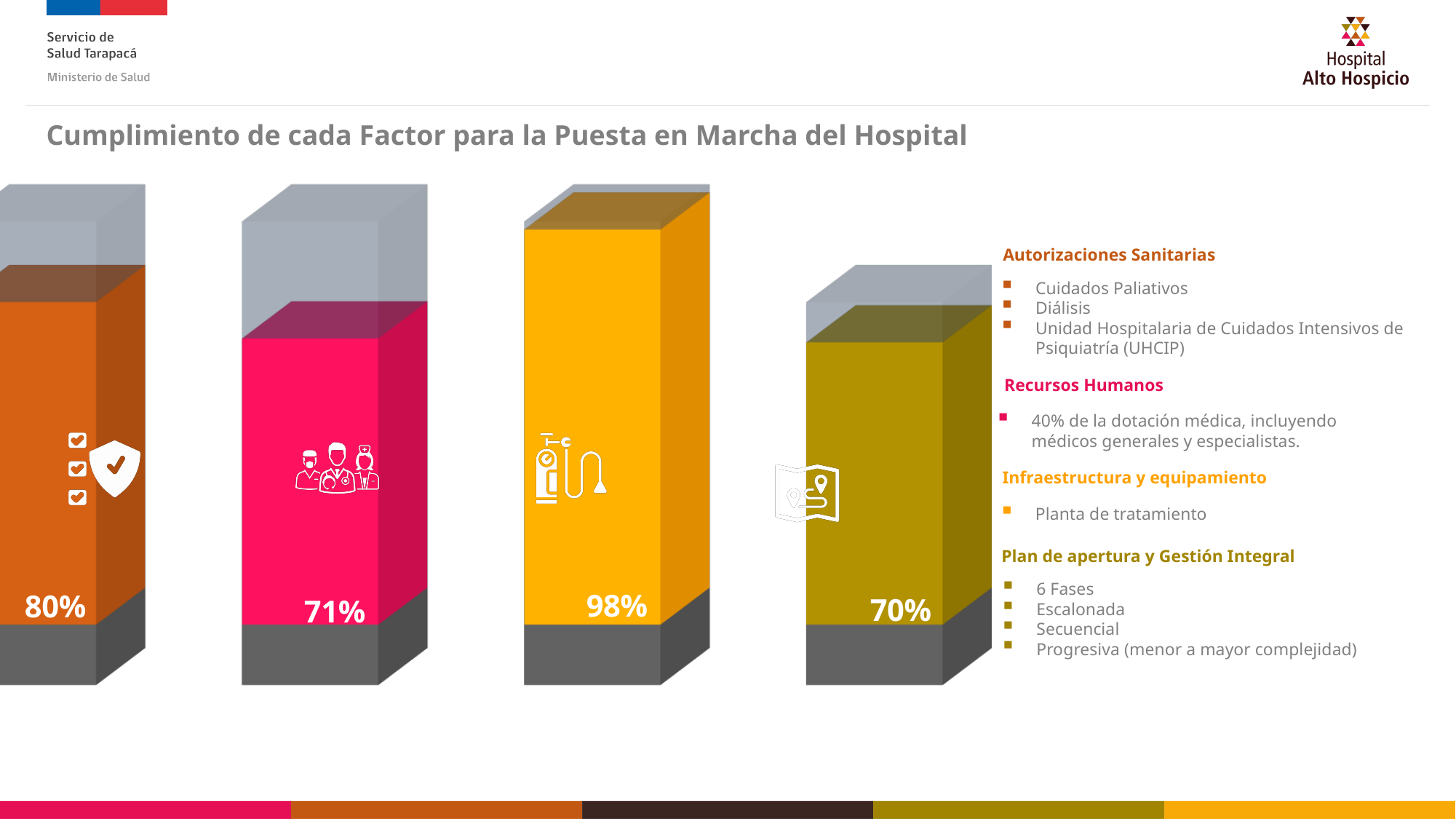
What kind of chart is shown on the slide? Bar chart What is the value shown for Recursos Humanos (the pink bar)? 71% What is the difference between the Autorizaciones Sanitarias value and the Plan de apertura y Gestión Integral value? 10% What is the value shown for Plan de apertura y Gestión Integral (the olive bar)? 70% Which factor has the lowest compliance percentage? Plan de apertura y Gestión Integral What is the difference between the Infraestructura y equipamiento value and the Recursos Humanos value? 27% How many bars (factors) are shown in the chart? 4 Which is larger, the value for Autorizaciones Sanitarias or the value for Recursos Humanos? Autorizaciones Sanitarias What is the title of the chart on the slide? Cumplimiento de cada Factor para la Puesta en Marcha del Hospital Which factor has the highest compliance percentage? Infraestructura y equipamiento What is the value shown for Autorizaciones Sanitarias (the orange bar)? 80% What is the value shown for Infraestructura y equipamiento (the yellow bar)? 98%